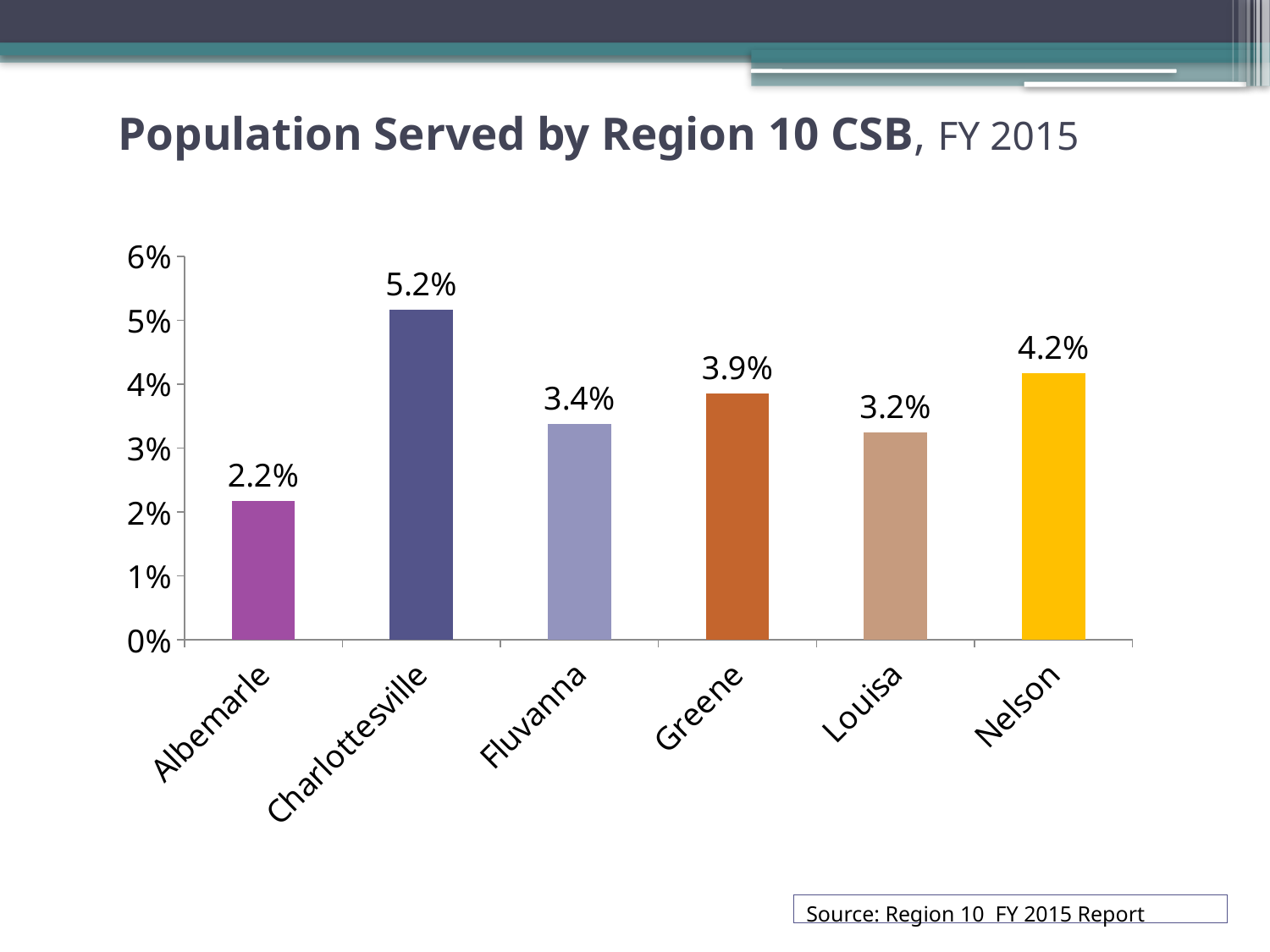
Is the value for Nelson greater or less than 4%? greater Which category has the lowest value? Albemarle What is the title of the chart on the slide? Population Served by Region 10 CSB, FY 2015 How many categories are shown on the chart? 6 What is the value for Louisa? 3.2% Which is larger, the value for Greene or the value for Fluvanna? Greene Which category has the highest value? Charlottesville What is the value for Charlottesville? 5.2% What kind of chart is shown on the slide? Bar chart What is the difference between the values for Nelson and Greene? 0.3% What is the value for Albemarle? 2.2% What is the difference between the values for Charlottesville and Albemarle? 3.0%